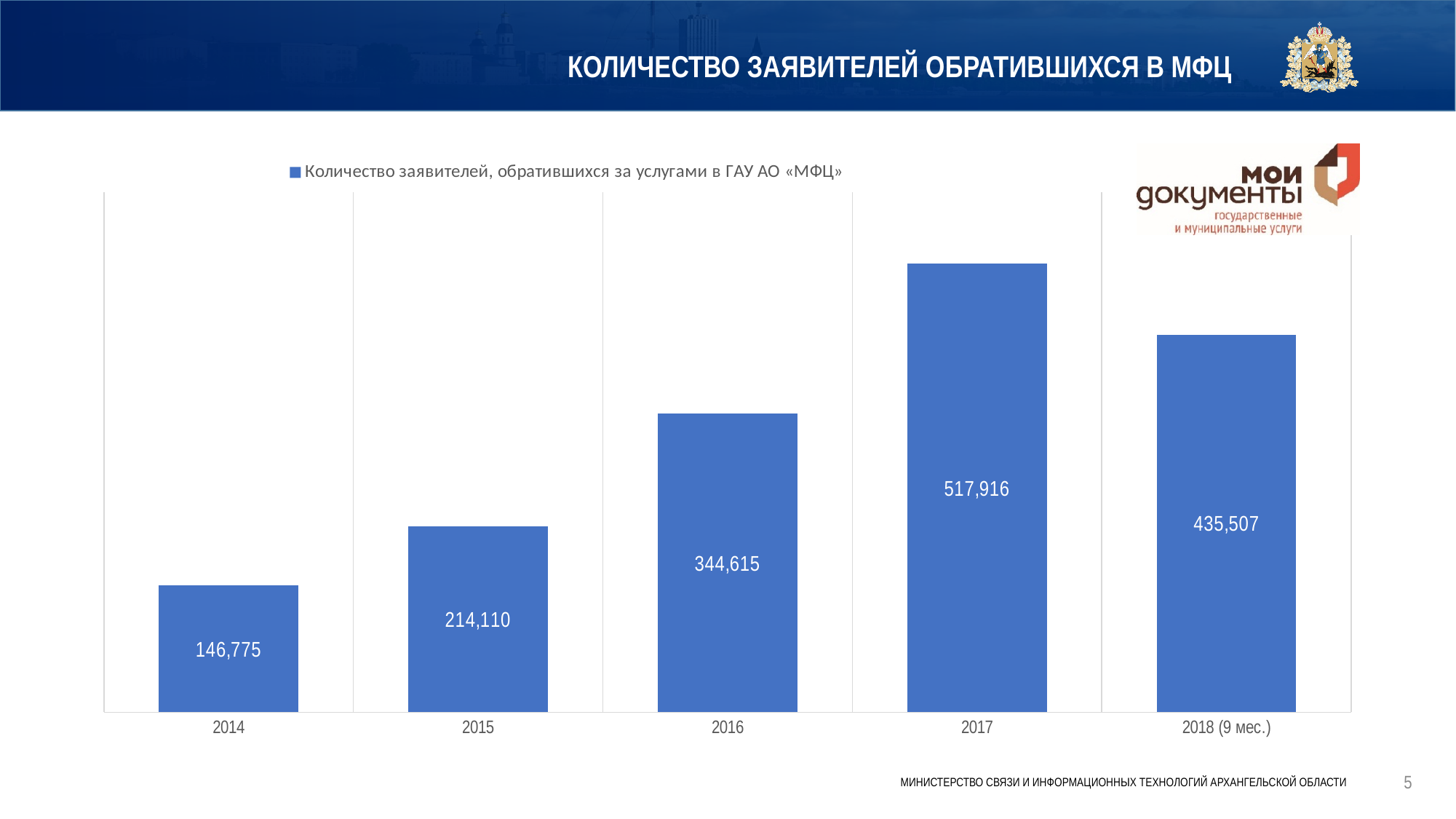
What is the difference between the values for 2015 and 2014? 67,335 Which year has the lowest value? 2014 What is the value for 2018 (9 мес.)? 435,507 How many categories are shown on the x axis? 5 What kind of chart is shown on the slide? Bar chart Which is larger, the value for 2017 or the value for 2018 (9 мес.)? 2017 What is the value for 2014? 146,775 Which year has the highest value? 2017 How many series does the legend list? 1 What is the difference between the values for 2017 and 2016? 173,301 Do the values rise or fall from 2014 to 2017? Rise What is the value for 2016? 344,615